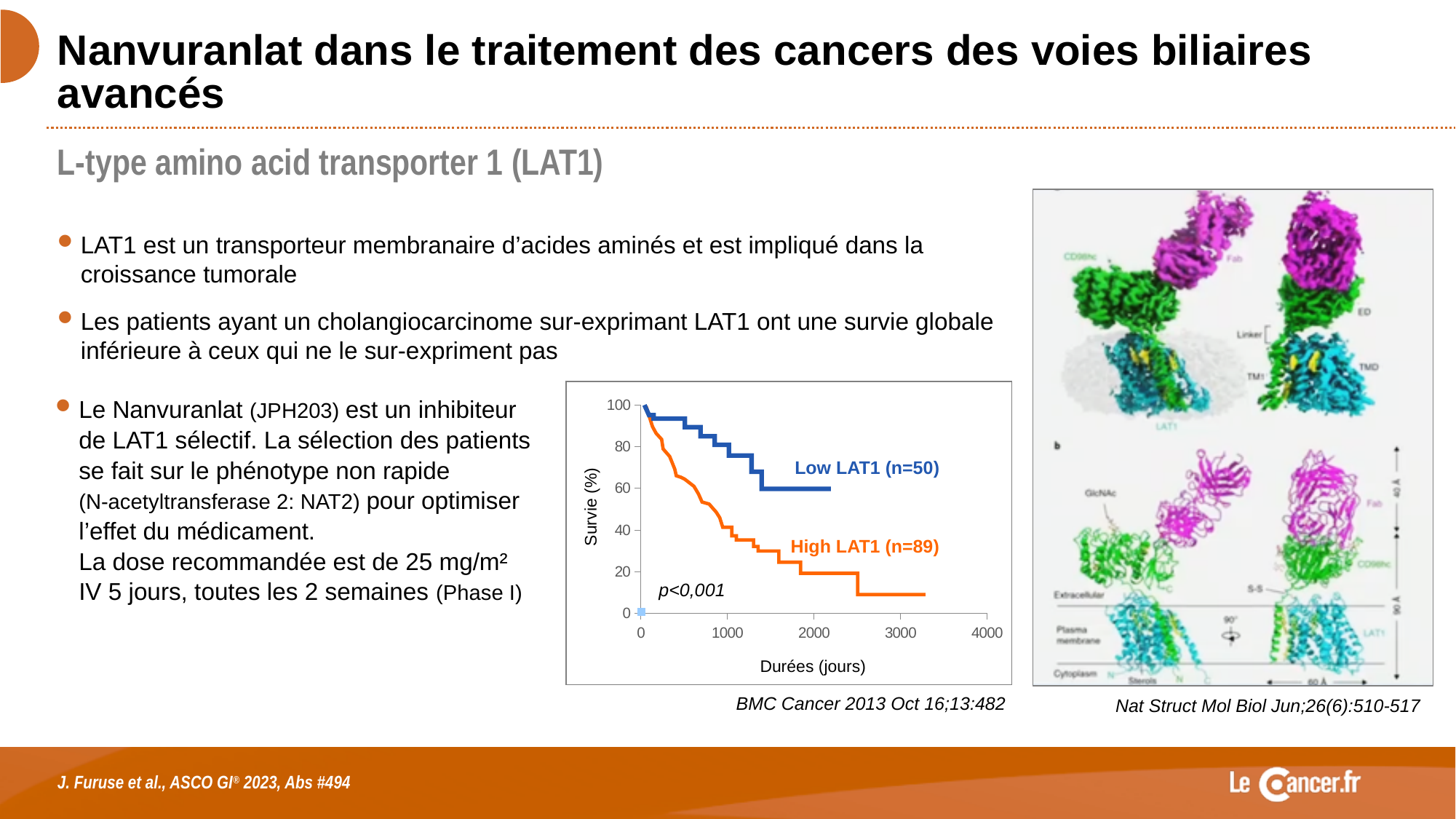
What kind of chart is shown on the slide? line chart Which curve reaches the lowest survival value on the chart? High LAT1 (n=89) Is the survival value for Low LAT1 at 500 days greater or less than 80? greater Is the survival value for Low LAT1 at 2000 days greater or less than 40? greater At 2000 days, which curve shows higher survival: Low LAT1 or High LAT1? Low LAT1 Is the survival value for High LAT1 at 500 days greater or less than 40? greater What is the label of the y axis of the chart? Survie (%) What is the highest value shown on the x axis of the chart? 4000 What is the label of the x axis of the chart? Durées (jours) How many series (curves) are plotted on the chart? 2 Do the survival curves rise or fall as the duration in days increases? fall